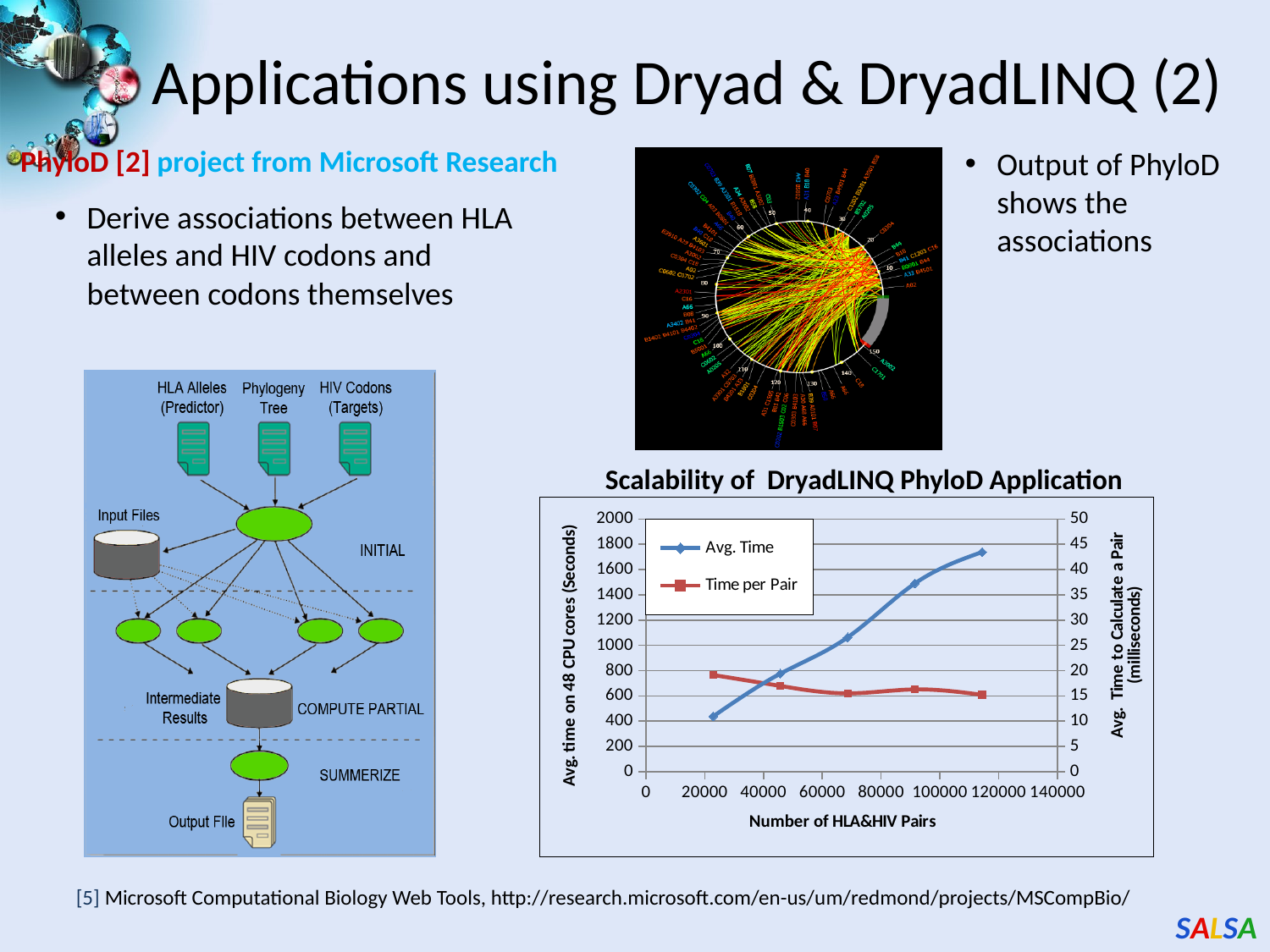
In the 'Scalability of DryadLINQ PhyloD Application' chart, is the Avg. Time at the leftmost data point greater or less than 600 seconds? less In the 'Scalability of DryadLINQ PhyloD Application' chart, is the Avg. Time at the largest number of pairs greater or less than 1600 seconds? greater In the 'Scalability of DryadLINQ PhyloD Application' chart, does Avg. Time rise or fall as the number of HLA&HIV pairs increases? rise In the 'Scalability of DryadLINQ PhyloD Application' chart, is the Time per Pair at the leftmost data point greater or less than 15 milliseconds? greater How many series does the legend of the 'Scalability of DryadLINQ PhyloD Application' chart list? 2 What kind of chart is 'Scalability of DryadLINQ PhyloD Application'? line chart In the 'Scalability of DryadLINQ PhyloD Application' chart, which series is plotted with red square markers? Time per Pair In the 'Scalability of DryadLINQ PhyloD Application' chart, at which data point is Avg. Time highest: the leftmost or the rightmost? rightmost What is the x-axis label of the 'Scalability of DryadLINQ PhyloD Application' chart? Number of HLA&HIV Pairs In the 'Scalability of DryadLINQ PhyloD Application' chart, how many data points are plotted for the Avg. Time series? 5 In the 'Scalability of DryadLINQ PhyloD Application' chart, does Time per Pair generally rise or fall as the number of HLA&HIV pairs increases? fall